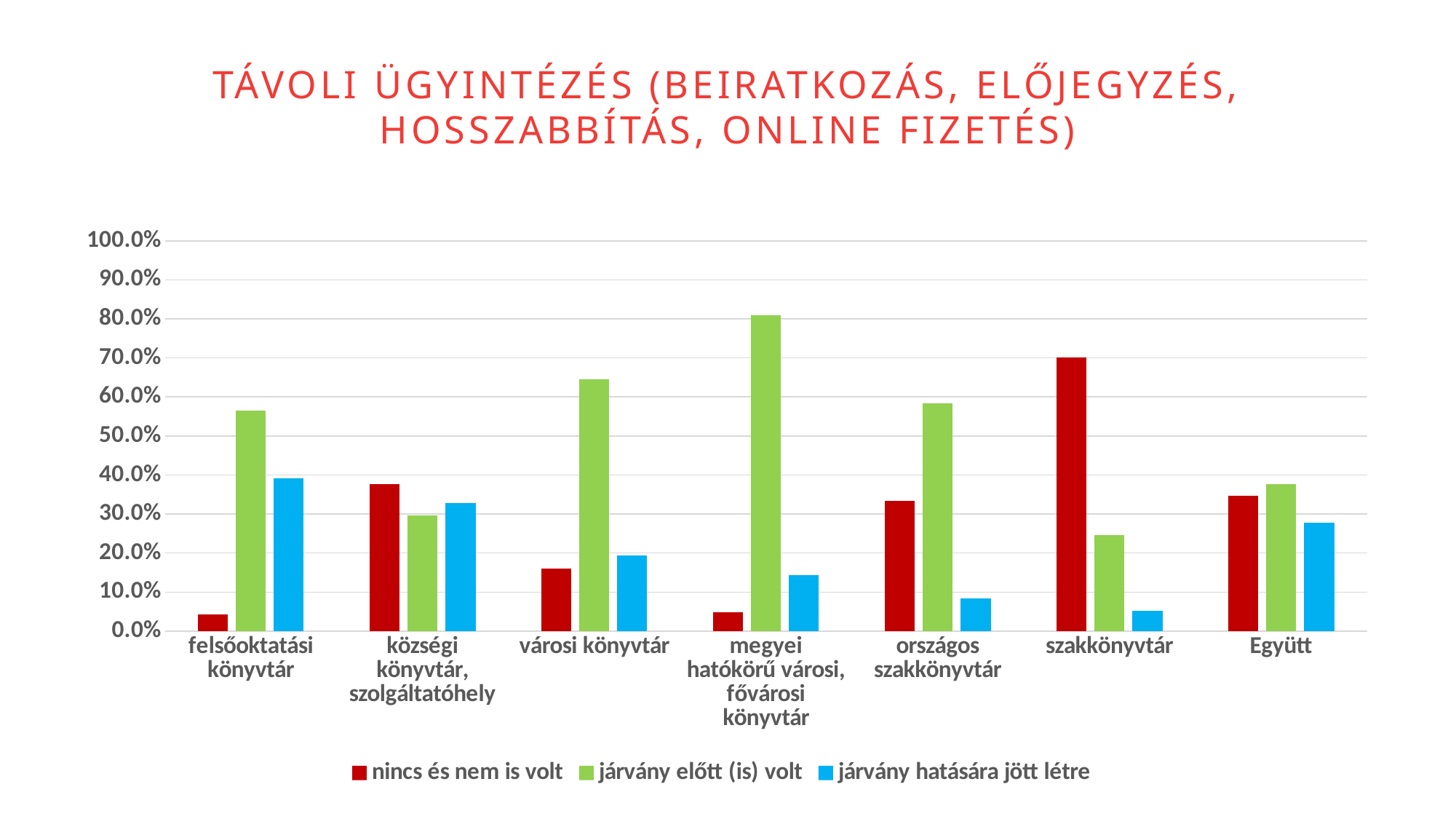
What colour represents the series "nincs és nem is volt" in the legend? red Is the value of "nincs és nem is volt" for szakkönyvtár greater or less than 60%? greater What kind of chart is shown on the slide? bar chart Which category has the highest value for the series "járvány hatására jött létre"? felsőoktatási könyvtár How many series does the legend list? 3 How many categories are shown on the x axis? 7 Is the value of "járvány előtt (is) volt" for megyei hatókörű városi, fővárosi könyvtár greater or less than 70%? greater Which category has the highest value for the series "nincs és nem is volt"? szakkönyvtár For községi könyvtár, szolgáltatóhely, which is larger: "nincs és nem is volt" or "járvány előtt (is) volt"? nincs és nem is volt For felsőoktatási könyvtár, which is larger: "járvány előtt (is) volt" or "járvány hatására jött létre"? járvány előtt (is) volt Is the value of "nincs és nem is volt" for városi könyvtár greater or less than 20%? less Which category has the highest value for the series "járvány előtt (is) volt"? megyei hatókörű városi, fővárosi könyvtár